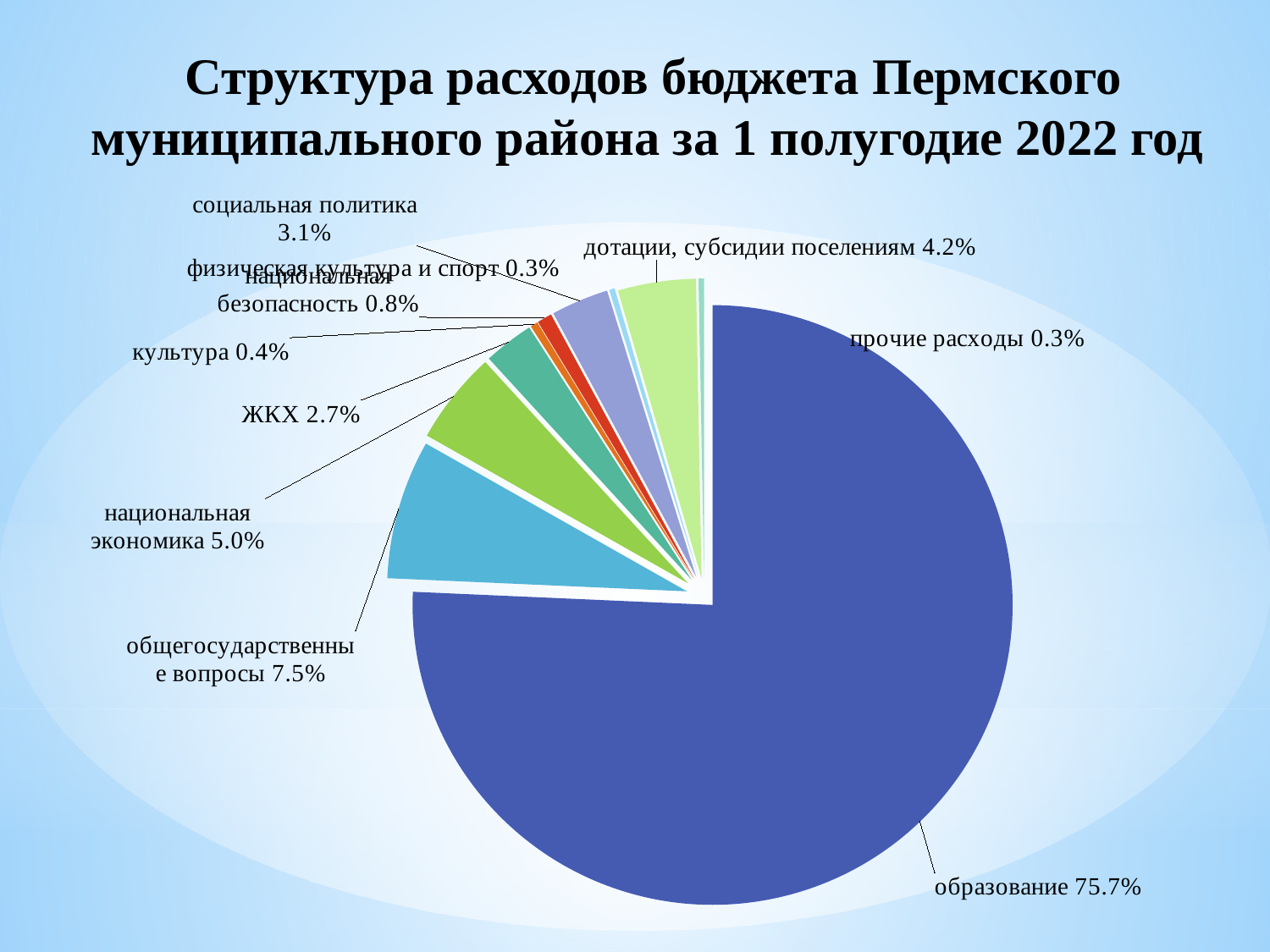
What is the value for ЖКХ? 2.7% What is the difference between общегосударственные вопросы and национальная экономика? 2.5% Which category has the largest share of the pie? образование What share of the budget expenditures goes to образование? 75.7% What type of chart is shown on the slide? pie chart What is the value for национальная экономика? 5.0% How many categories (slices) does the pie chart have? 10 What is the value for общегосударственные вопросы? 7.5% Which is larger: национальная экономика or дотации, субсидии поселениям? национальная экономика What is the title of the slide? Структура расходов бюджета Пермского муниципального района за 1 полугодие 2022 год What is the value for дотации, субсидии поселениям? 4.2% What is the value for социальная политика? 3.1%